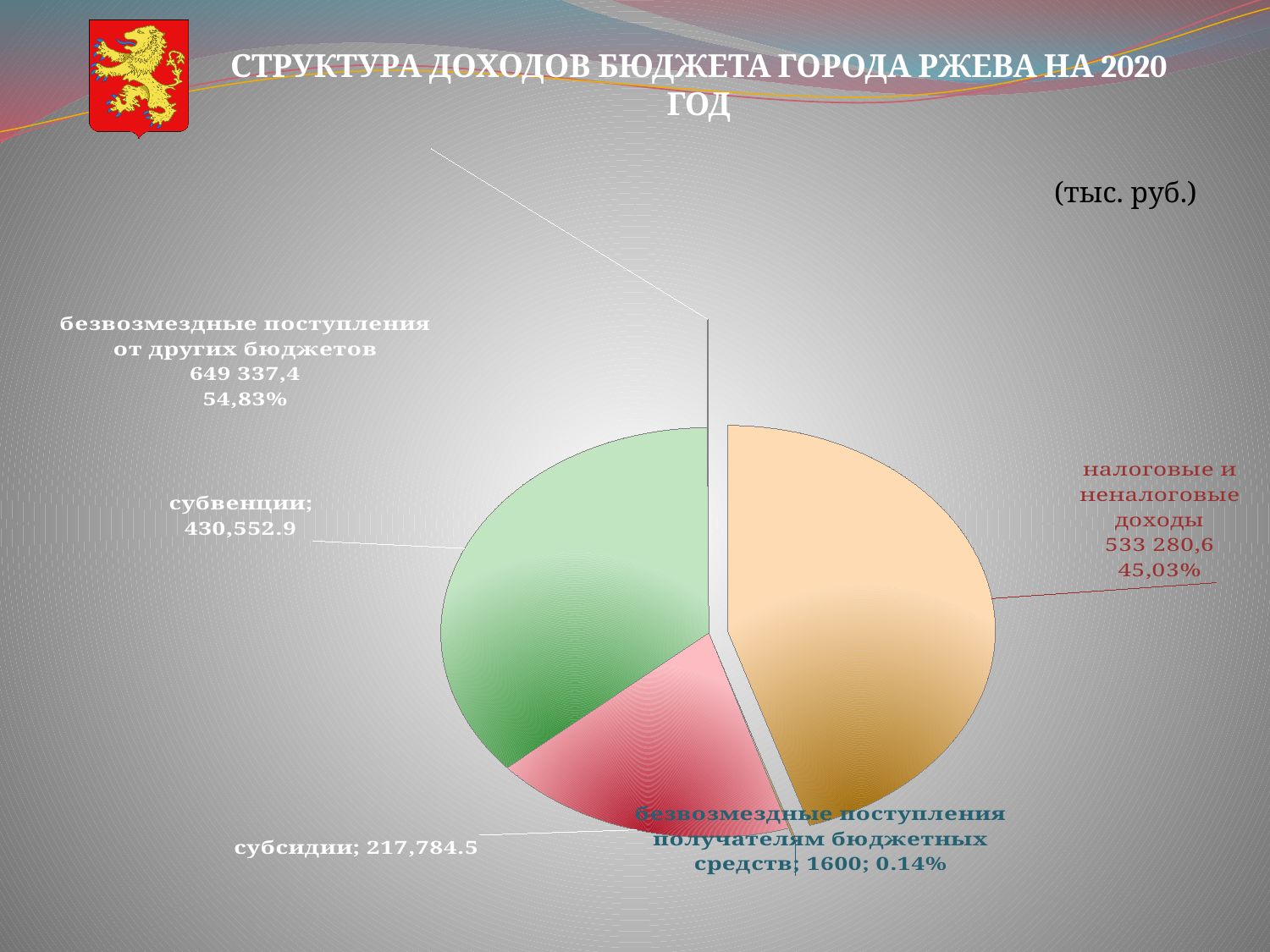
What is the value shown for безвозмездные поступления получателям бюджетных средств? 1600 What is the value shown for налоговые и неналоговые доходы? 533 280,6 What is the difference between субвенции and субсидии? 212,768.4 Which is larger, субвенции or субсидии? субвенции In what units are the values on the chart given? тыс. руб. What kind of chart is shown on the slide? pie chart What is the value shown for субсидии? 217,784.5 What is the value shown for субвенции? 430,552.9 What share of the pie is налоговые и неналоговые доходы? 45,03% What share of the pie is безвозмездные поступления получателям бюджетных средств? 0.14% What value is shown for безвозмездные поступления от других бюджетов? 649 337,4